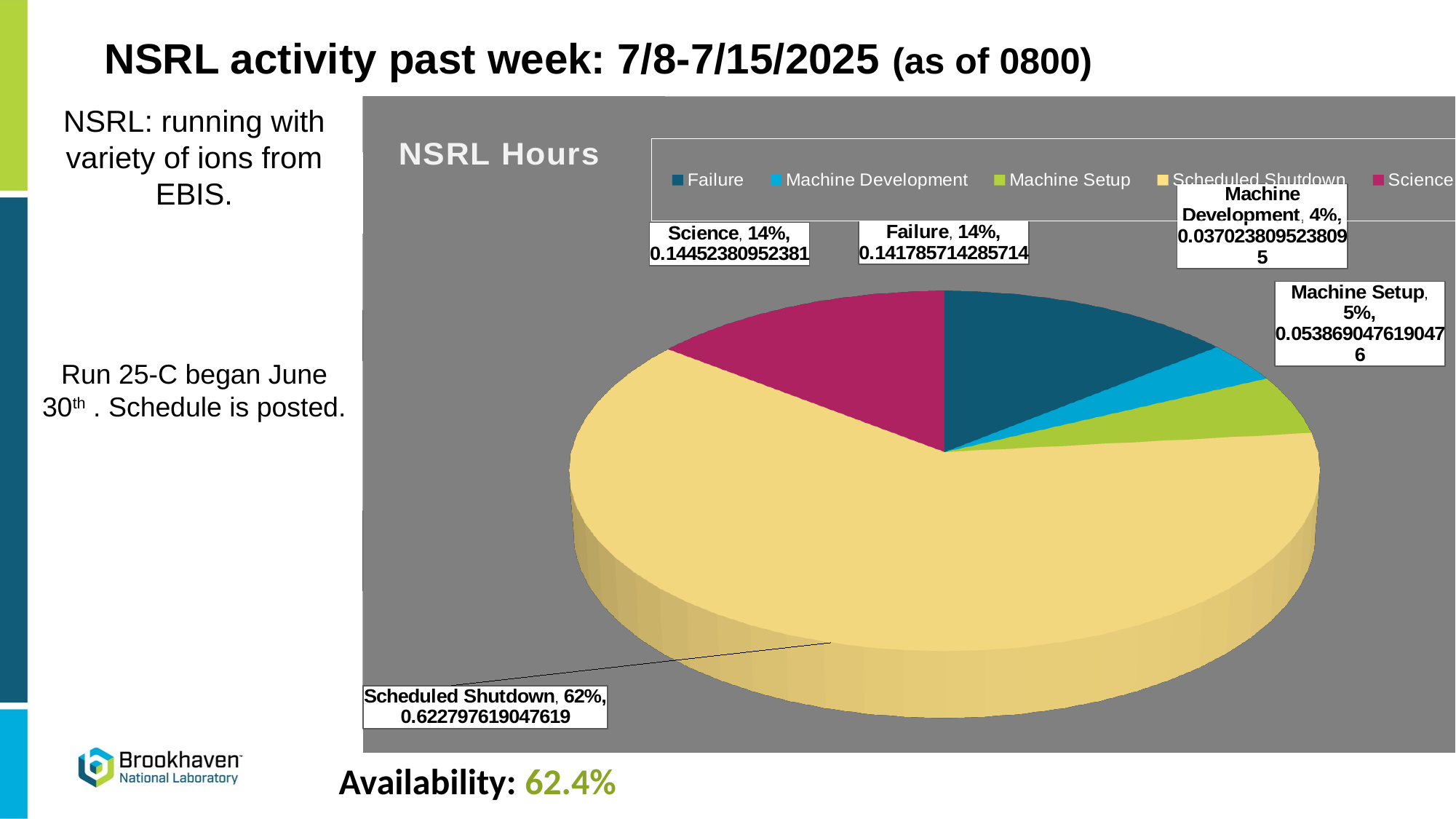
Which category has the largest share of the pie? Scheduled Shutdown How many slices does the pie chart have? 5 What kind of chart is shown on the slide? pie chart What is the title of the chart? NSRL Hours What is the difference in percentage points between the Scheduled Shutdown share and the Science share? 48 What percentage share does Machine Setup have? 5% How many entries does the chart legend list? 5 What percentage share does Scheduled Shutdown have? 62% What percentage share does Failure have? 14% Which category has the smallest share of the pie? Machine Development What is the decimal value printed for Science? 0.14452380952381 Which has the larger share, Machine Setup or Machine Development? Machine Setup